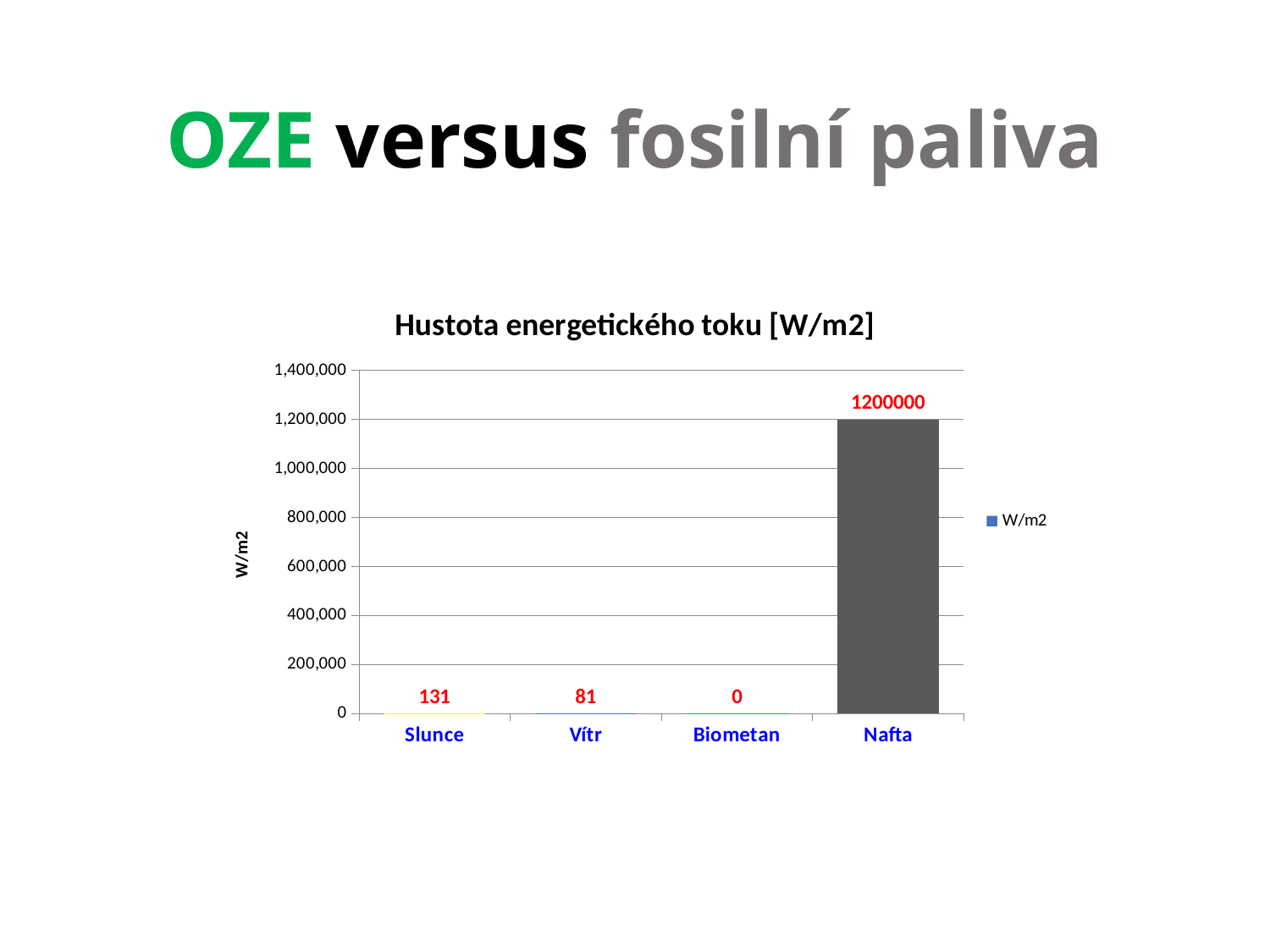
Which category has the highest value? Nafta What is the value for Vítr? 81 Which is larger, the value for Slunce or the value for Vítr? Slunce What is the value for Slunce? 131 What kind of chart is shown? bar chart Is the value for Nafta greater or less than 1,000,000? greater What is the title of the chart? Hustota energetického toku [W/m2] How many categories are shown on the x axis? 4 What is the value for Nafta? 1200000 What is the difference between the values for Slunce and Vítr? 50 Which category has the lowest value? Biometan What is the value for Biometan? 0